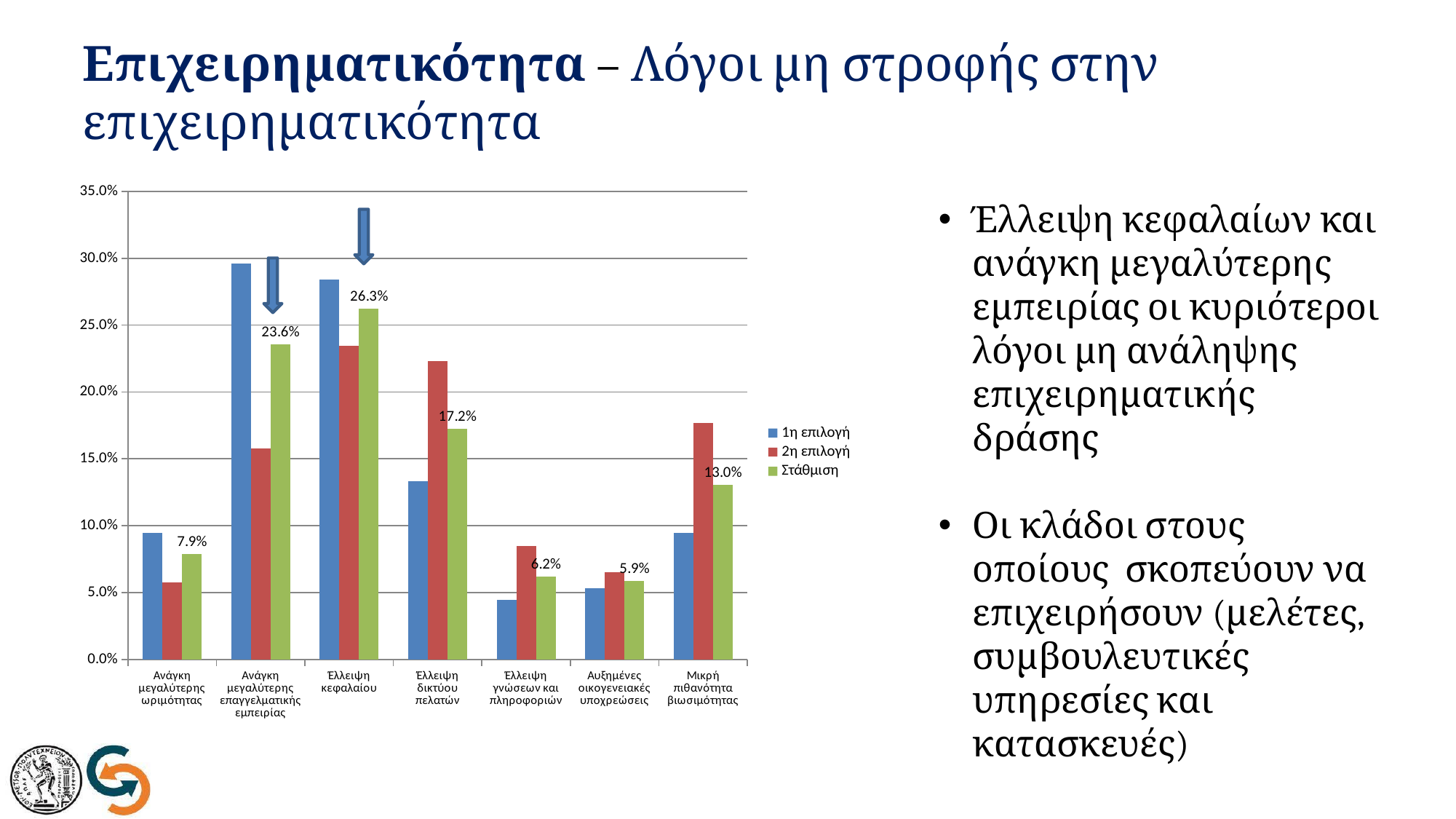
How many categories are shown on the x axis of the chart? 7 How many series does the chart legend list? 3 What is the Στάθμιση value for Μικρή πιθανότητα βιωσιμότητας? 13.0% What is the Στάθμιση value for Έλλειψη κεφαλαίου? 26.3% What type of chart is shown on the slide? bar chart Is the 1η επιλογή value for Ανάγκη μεγαλύτερης επαγγελματικής εμπειρίας greater or less than 25.0%? greater Which category has the highest Στάθμιση value? Έλλειψη κεφαλαίου Which legend entry is shown in green? Στάθμιση What is the Στάθμιση value for Ανάγκη μεγαλύτερης επαγγελματικής εμπειρίας? 23.6% What is the difference between the Στάθμιση values for Έλλειψη κεφαλαίου and Έλλειψη δικτύου πελατών? 9.1% Which category has the lowest Στάθμιση value? Αυξημένες οικογενειακές υποχρεώσεις Which is larger for Μικρή πιθανότητα βιωσιμότητας: the 1η επιλογή value or the 2η επιλογή value? 2η επιλογή